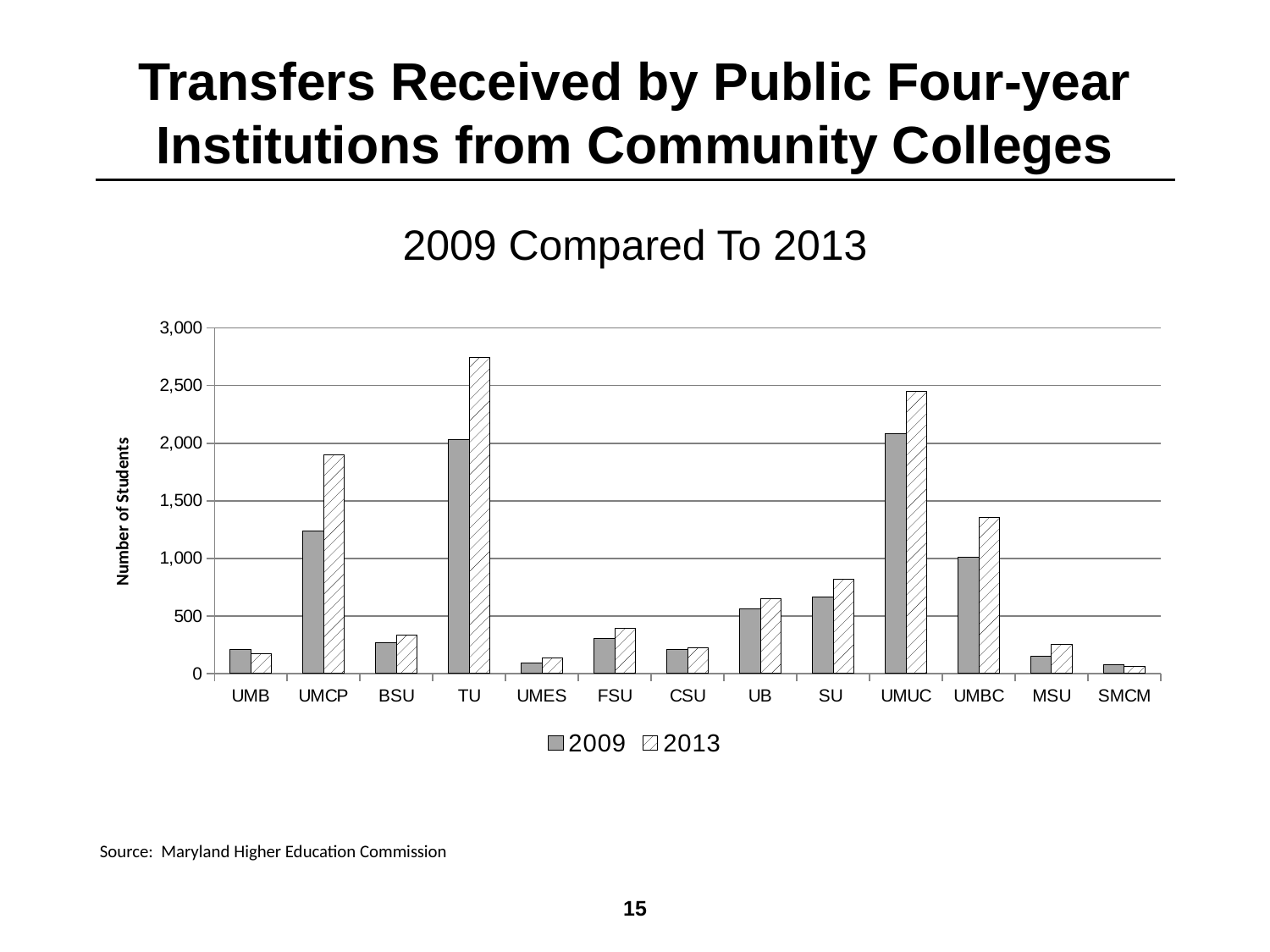
Is the 2009 value for UMES greater or less than 500? less Which institution has the lowest value for 2009? SMCM Is the 2013 value for UMCP greater or less than 1,500? greater Which institution has the lowest value for 2013? SMCM How many series does the chart's legend list? 2 Is the 2013 value for TU greater or less than 2,500? greater What kind of chart is shown on the slide? bar chart What is the label on the vertical axis of the chart? Number of Students For UMCP, which is larger: the 2009 value or the 2013 value? 2013 How many institutions are shown on the x axis of the chart? 13 Which institution has the highest value for 2013? TU